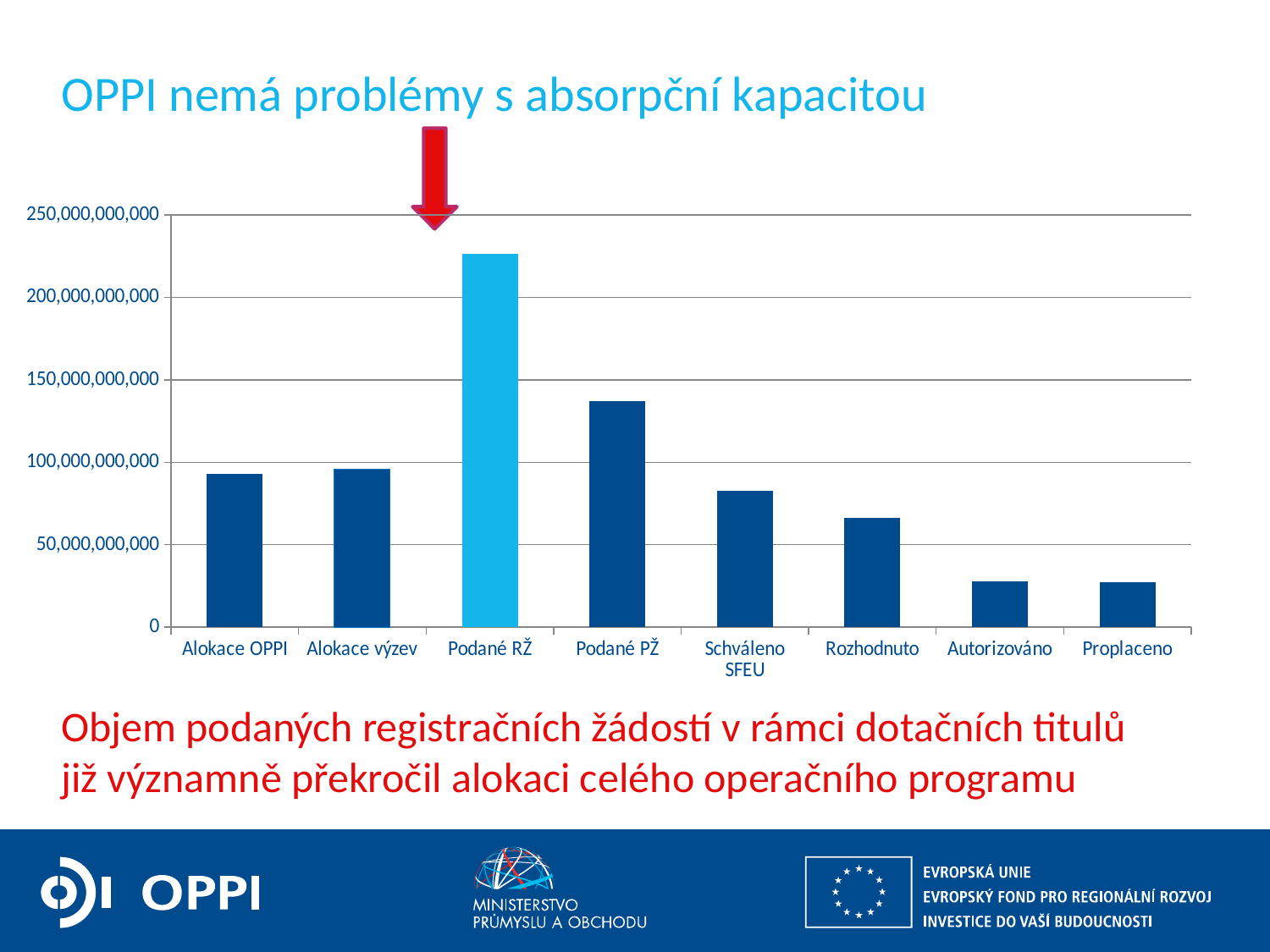
Is the value for Schváleno SFEU greater or less than 100,000,000,000? less How many categories are shown on the x axis of the chart? 8 Do the values rise or fall along the x axis from Podané RŽ to Proplaceno? fall Which bar in the chart is highlighted in a lighter blue colour? Podané RŽ Which is larger, the value for Podané PŽ or the value for Schváleno SFEU? Podané PŽ Which category has the highest value in the chart? Podané RŽ Is the value for Rozhodnuto greater or less than 50,000,000,000? greater What kind of chart is shown on the slide? bar chart Is the value for Podané PŽ greater or less than 100,000,000,000? greater